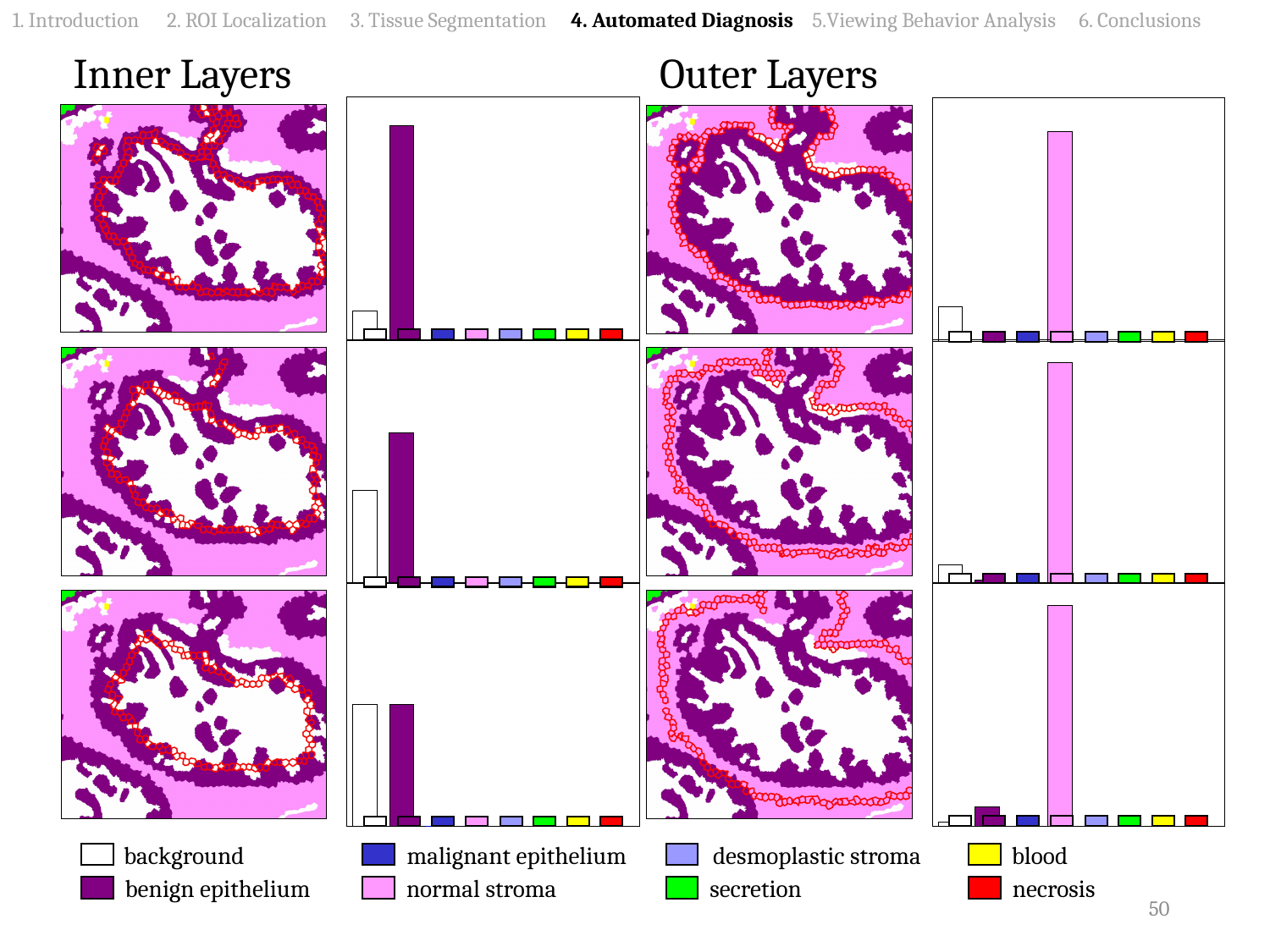
How many bars are shown in the middle chart under Outer Layers? 8 In the top chart under Inner Layers, which category has the tallest bar? benign epithelium In the bottom chart under Outer Layers, which category has the tallest bar? normal stroma In the top chart under Outer Layers, which is larger: the bar for background or the bar for benign epithelium? background In the middle chart under Inner Layers, which category has the tallest bar? benign epithelium What kind of chart is the top chart under Inner Layers? bar chart In the top chart under Inner Layers, which is larger: the bar for background or the bar for benign epithelium? benign epithelium According to the legend, which tissue class is shown in yellow? blood How many categories does the legend at the bottom of the slide list? 8 In the bottom chart under Outer Layers, which is larger: the bar for benign epithelium or the bar for malignant epithelium? benign epithelium According to the legend, which tissue class is shown in green? secretion